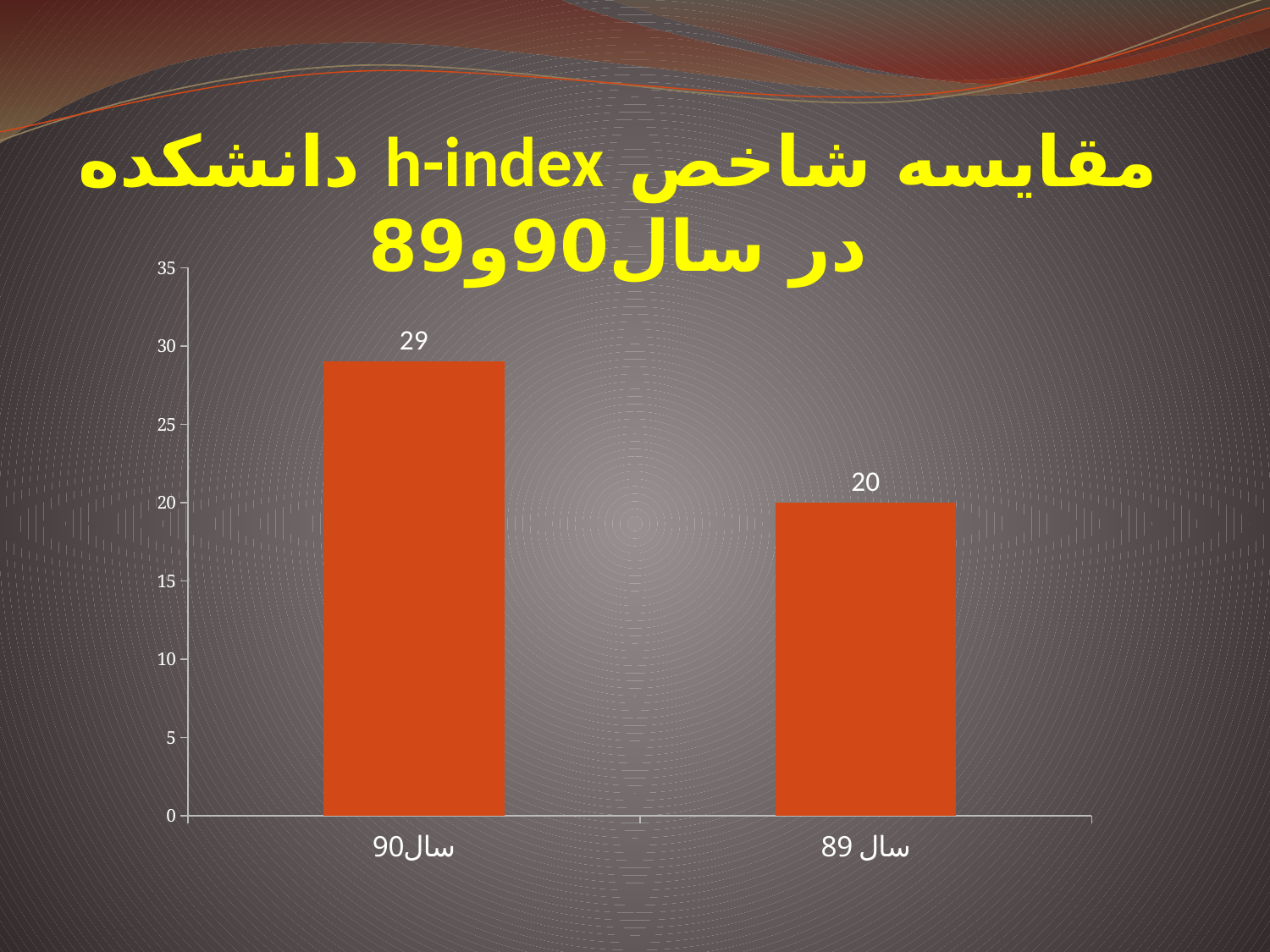
What is the maximum value shown on the y axis? 35 What is the h-index value for سال90? 29 What colour are the bars in the chart? orange-red What is the difference between the h-index for سال90 and سال 89? 9 Which year has the higher h-index? سال90 Is the value for سال 89 greater or less than 25? less What kind of chart is shown on the slide? bar chart Is the value for سال90 larger or smaller than the value for سال 89? larger Is the value for سال90 greater or less than 25? greater Which year has the lower h-index? سال 89 How many categories are shown on the x axis? 2 What is the h-index value for سال 89? 20